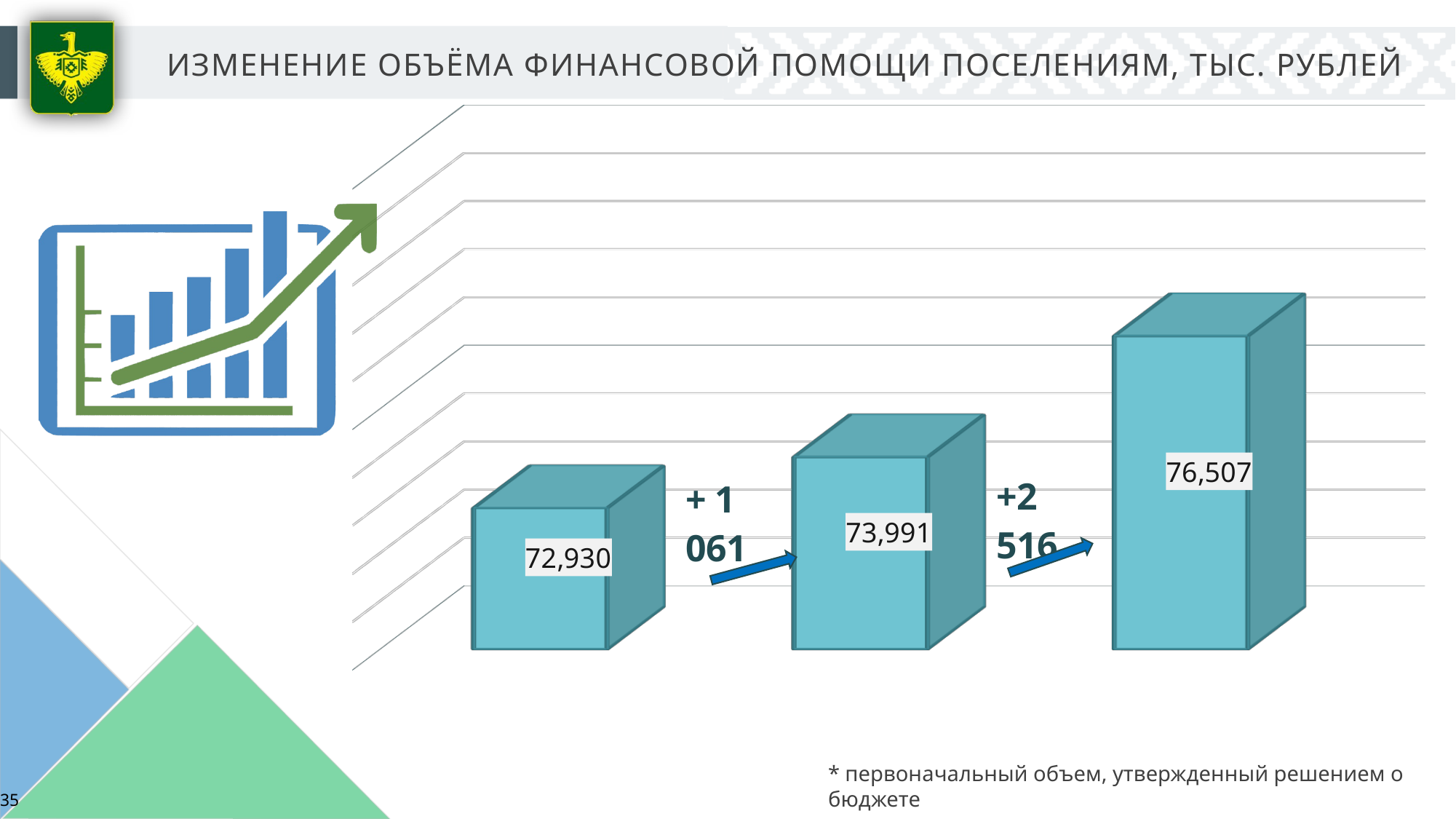
Which bar has the lowest value? the leftmost bar (72,930) What is the difference between the middle bar and the leftmost bar? 1,061 What type of chart is shown on the slide? bar chart What is the value shown on the rightmost bar? 76,507 What is the value shown on the middle bar? 73,991 What is the title of the slide's chart? ИЗМЕНЕНИЕ ОБЪЁМА ФИНАНСОВОЙ ПОМОЩИ ПОСЕЛЕНИЯМ, ТЫС. РУБЛЕЙ How many bars are plotted in the chart? 3 What is the value shown on the leftmost bar? 72,930 Which bar has the highest value? the rightmost bar (76,507) What is the difference between the rightmost bar and the leftmost bar? 3,577 Which is larger, the value of the middle bar or the rightmost bar? the rightmost bar Do the values rise or fall from left to right across the chart? rise